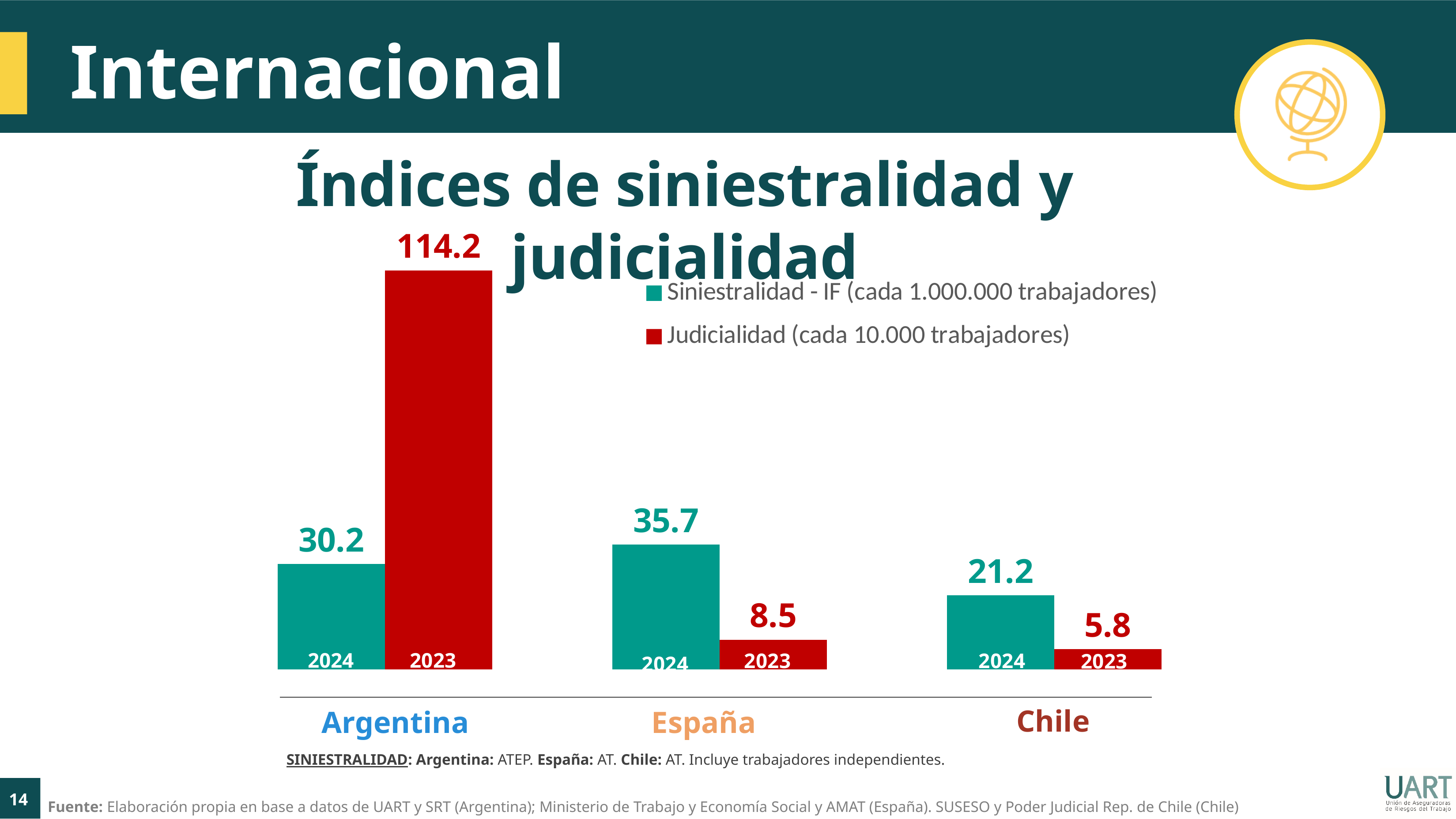
Which country has the lowest Judicialidad value? Chile How many series does the chart legend list? 2 Which is larger, the Siniestralidad - IF value for Chile or the Judicialidad value for Chile? Siniestralidad - IF value for Chile Which year is labelled on the Judicialidad bars? 2023 What is the Siniestralidad - IF value for Argentina? 30.2 How many countries are shown on the x axis of the chart? 3 What is the Judicialidad value for Chile? 5.8 Which country has the highest Siniestralidad - IF value? España What type of chart is shown on the slide? Bar chart What is the difference between the Judicialidad values for Argentina and España? 105.7 What is the Siniestralidad - IF value for España? 35.7 What is the Judicialidad value for Argentina? 114.2